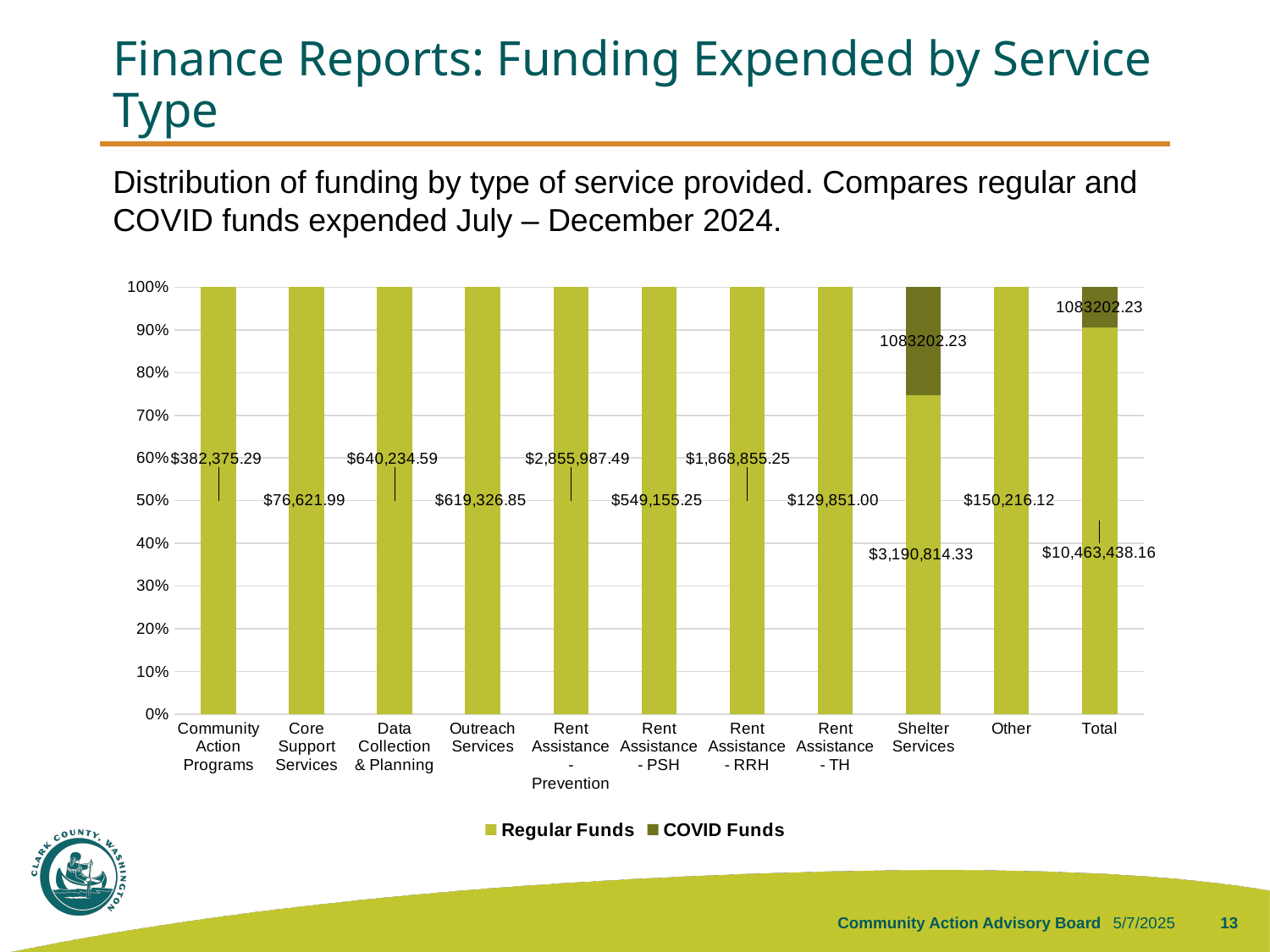
Which category has the lowest Regular Funds value? Core Support Services What is the Regular Funds value for Community Action Programs? $382,375.29 How many series does the legend list? 2 What is the difference between the Regular Funds values for Rent Assistance - Prevention and Rent Assistance - RRH? $987,132.24 What is the COVID Funds value labelled for Shelter Services? 1083202.23 How many categories are shown on the x axis? 11 What is the Regular Funds value for Rent Assistance - Prevention? $2,855,987.49 Is the Regular Funds share of the Shelter Services bar greater or less than 80%? less What is the Regular Funds value for the Total category? $10,463,438.16 Which has a larger Regular Funds value, Data Collection & Planning or Outreach Services? Data Collection & Planning What kind of chart is shown on the slide? Stacked bar chart Which service type (excluding Total) has the highest Regular Funds value? Shelter Services